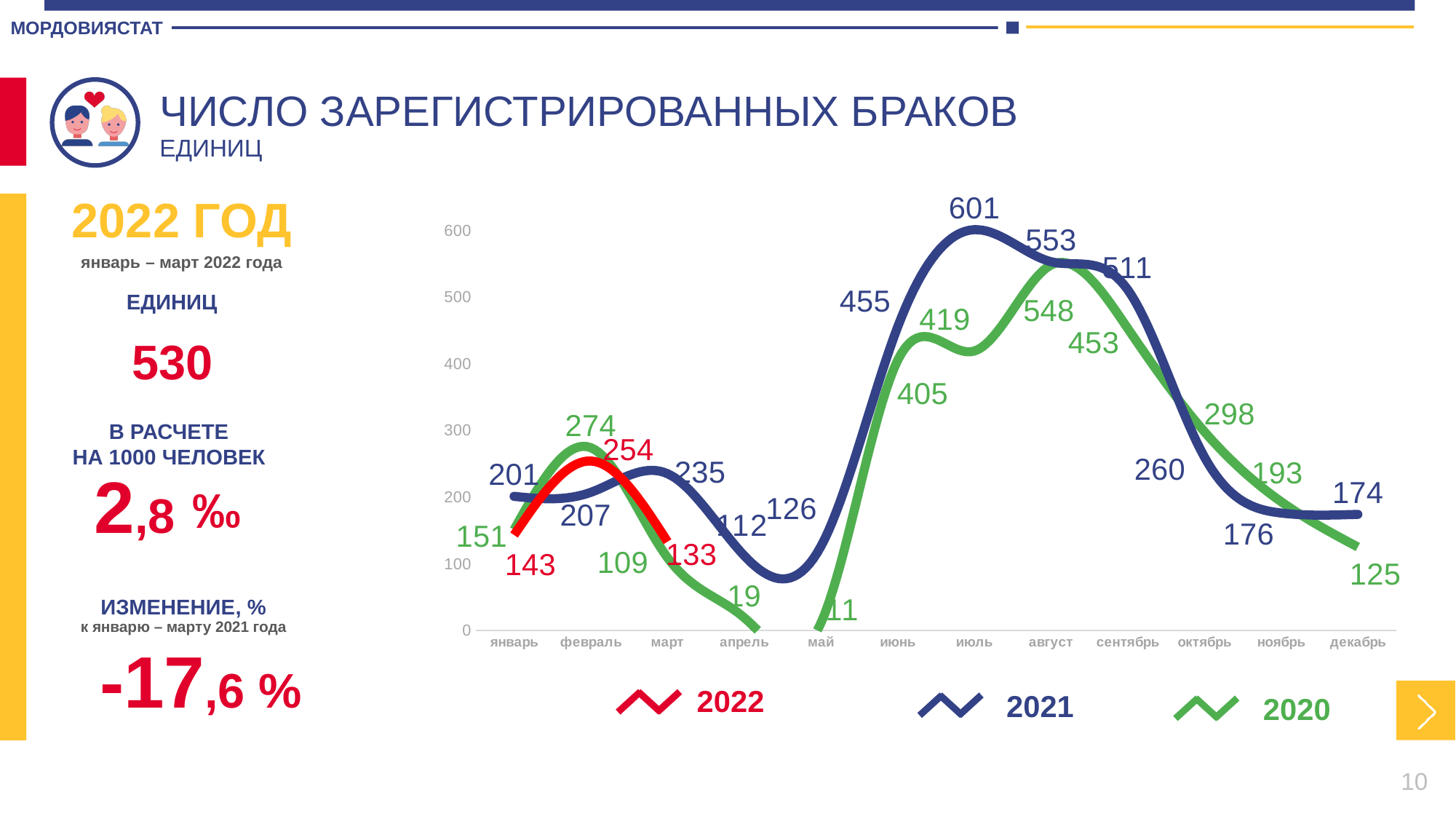
Which series has the larger value in февраль (February): 2022 or 2021? 2022 What is the difference between the 2021 and 2020 values in июль (July)? 182 How many months are shown on the x axis? 12 What is the value for 2020 in август (August)? 548 What kind of chart is shown on the slide? line chart What is the value for 2021 in июль (July)? 601 What is the value for 2022 in февраль (February)? 254 How many series does the legend list? 3 Does the 2021 series rise or fall from июль (July) to декабрь (December)? fall What is the value for 2020 in декабрь (December)? 125 In which month does the 2020 series have its lowest value? май In which month does the 2021 series reach its highest value? июль